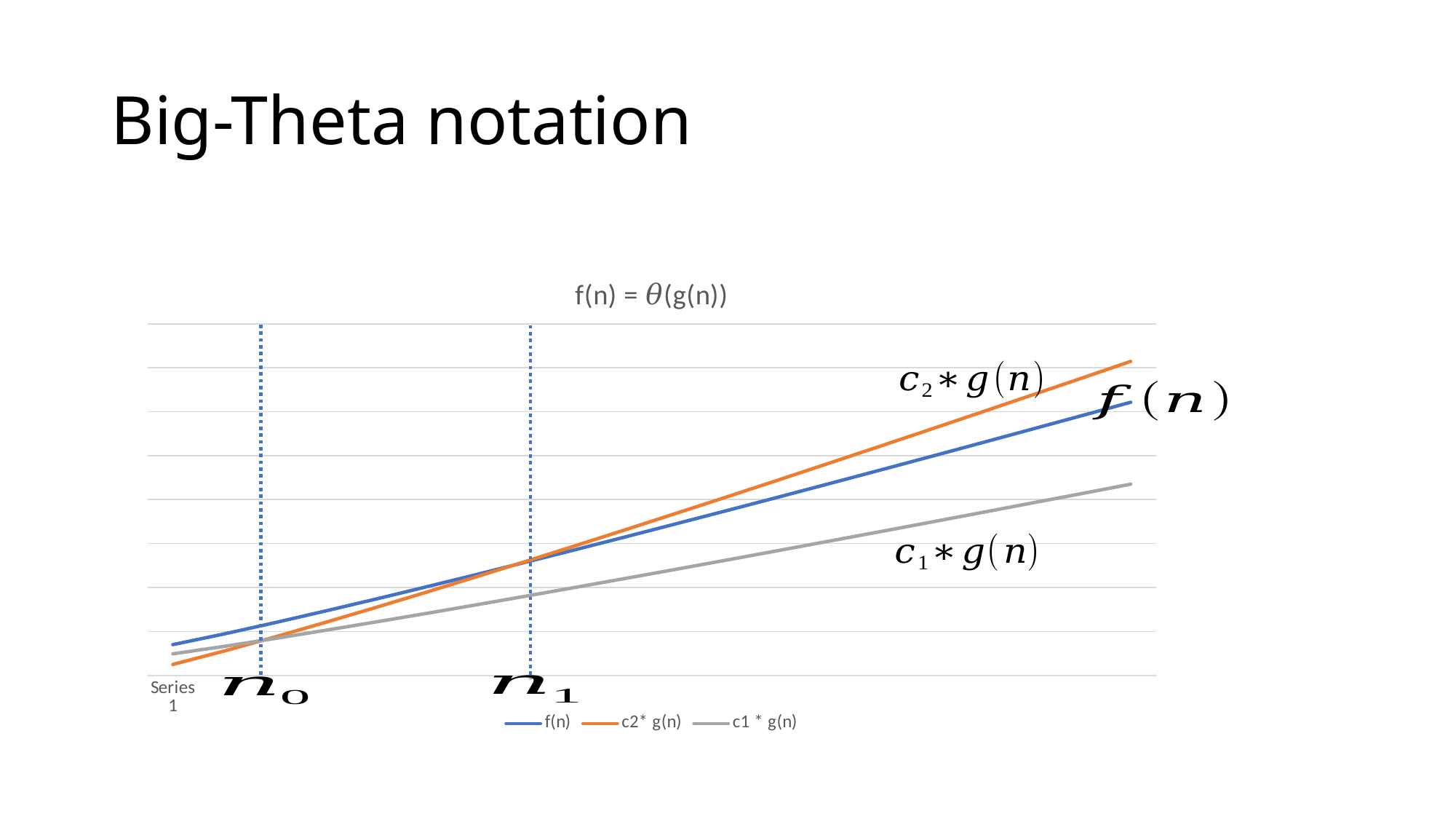
At the right end of the chart, which series has the lowest value? c1 * g(n) Do the values of the c1 * g(n) series rise or fall from left to right along the x axis? rise Which series is drawn in orange according to the legend? c2* g(n) What is the title of the chart? f(n) = θ(g(n)) At the right end of the chart, which is larger: c2* g(n) or f(n)? c2* g(n) What kind of chart is shown on the slide? line chart Do the values of the f(n) series rise or fall from left to right along the x axis? rise At the left end of the chart, which is larger: f(n) or c2* g(n)? f(n) At the right end of the chart, which is larger: f(n) or c1 * g(n)? f(n) How many series does the chart legend list? 3 At the right end of the chart, which series has the highest value? c2* g(n)